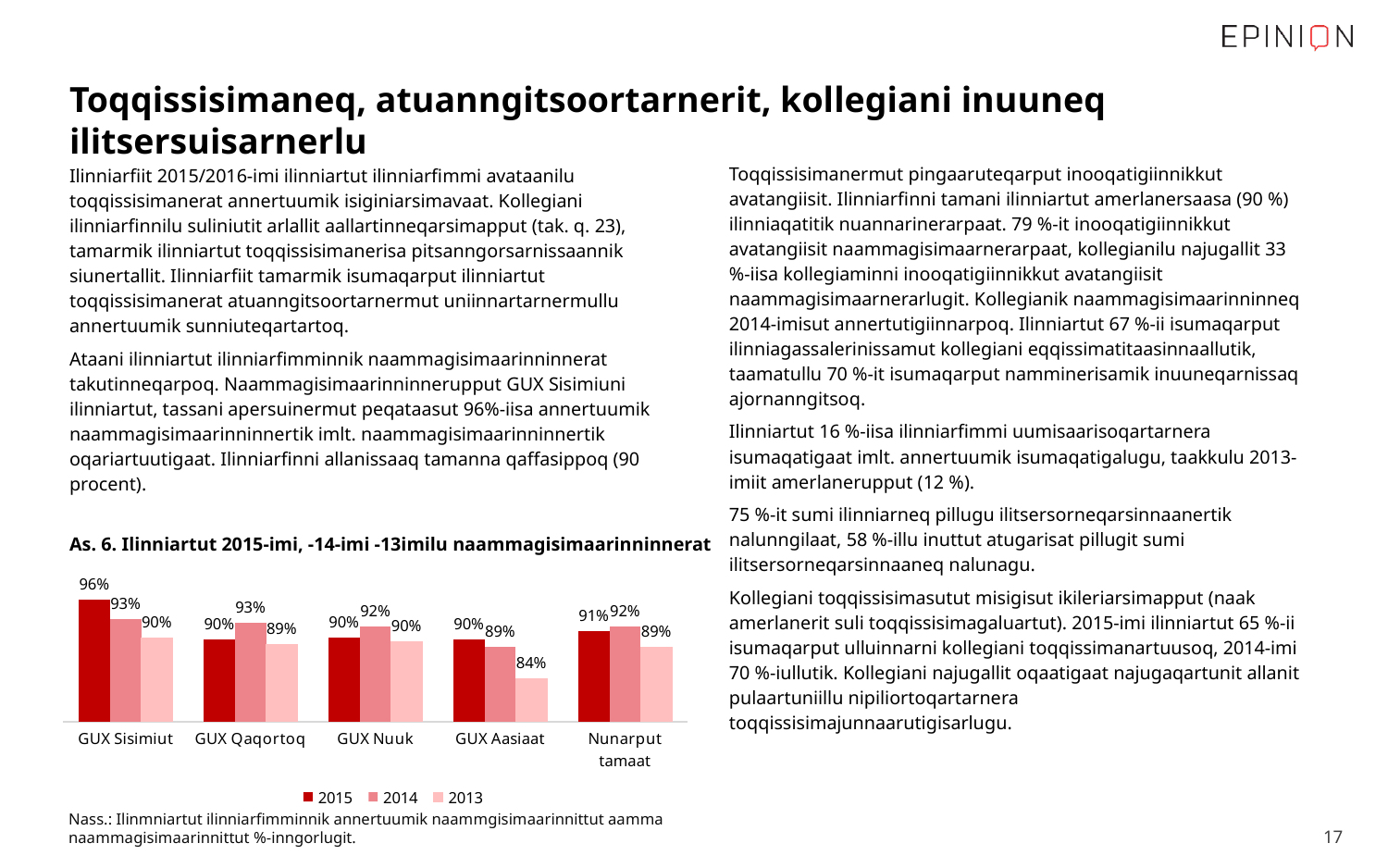
What is the 2013 value for GUX Aasiaat? 84% Which is larger for GUX Nuuk, the 2014 value or the 2013 value? 2014 What is the difference between the 2015 and 2013 values for GUX Sisimiut? 6 percentage points Which category has the lowest 2013 value? GUX Aasiaat Which category has the highest 2015 value? GUX Sisimiut What is the 2015 value for Nunarput tamaat? 91% How many series does the legend list? 3 How many categories are shown on the x axis? 5 What kind of chart is shown on the slide? Bar chart What is the 2014 value for GUX Qaqortoq? 93% What is the 2015 value for GUX Sisimiut? 96% Which series is shown in the darkest red colour in the legend? 2015